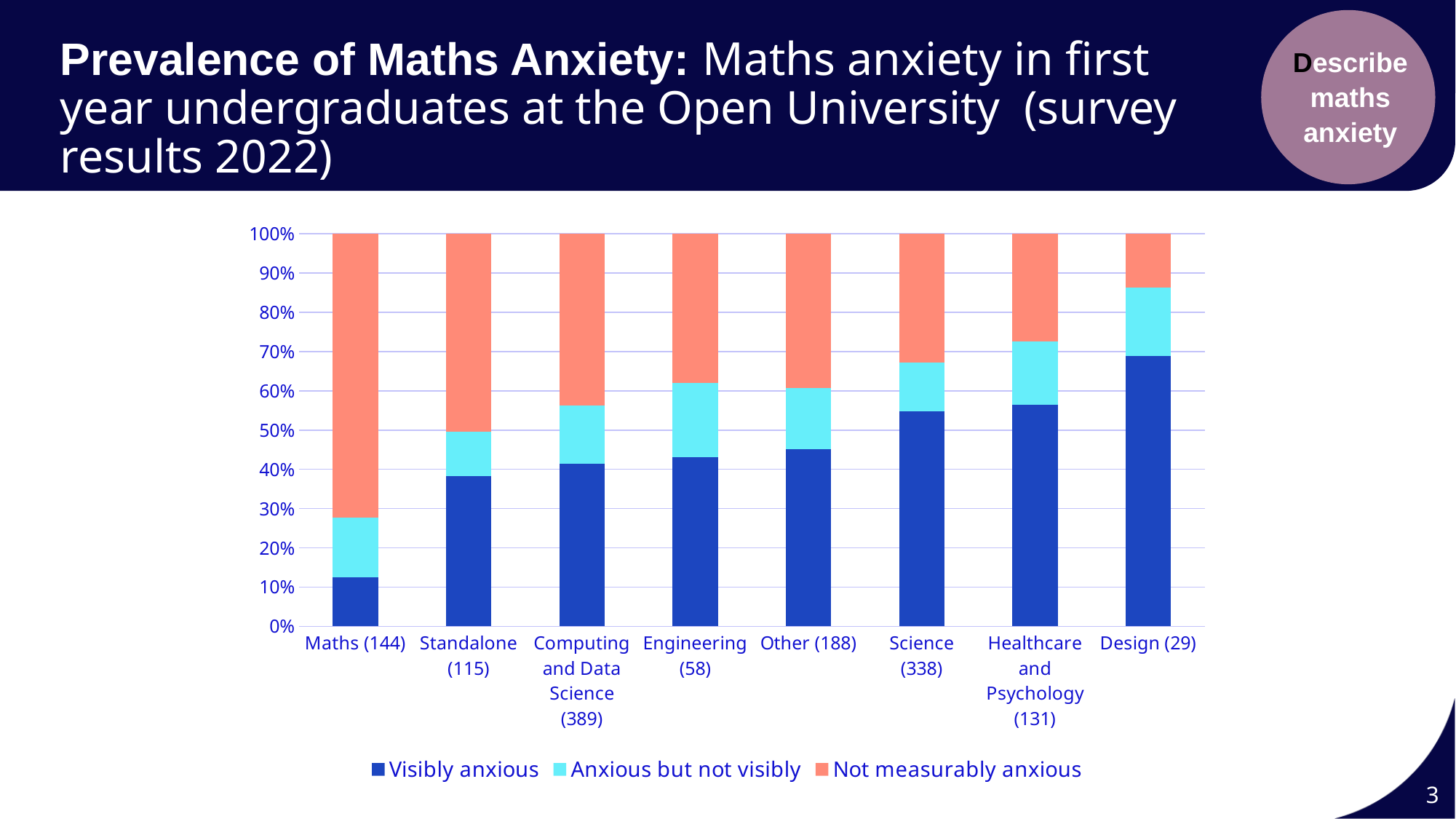
How many series does the legend list? 3 What colour represents the Not measurably anxious series in the legend? Orange (salmon) Is the Visibly anxious share for Science (338) greater or less than 50%? greater What kind of chart is shown on the slide? Stacked bar chart Which category has the highest share of Visibly anxious students? Design (29) Which has a larger Visibly anxious share, Science (338) or Standalone (115)? Science (338) Which category has the largest share of Not measurably anxious students? Maths (144) Is the Visibly anxious share for Design (29) greater or less than 60%? greater Is the Visibly anxious share for Maths (144) greater or less than 20%? less Moving from left to right along the x axis, does the Visibly anxious share rise or fall? rise Which category has the lowest share of Visibly anxious students? Maths (144) How many subject categories are shown on the x axis? 8